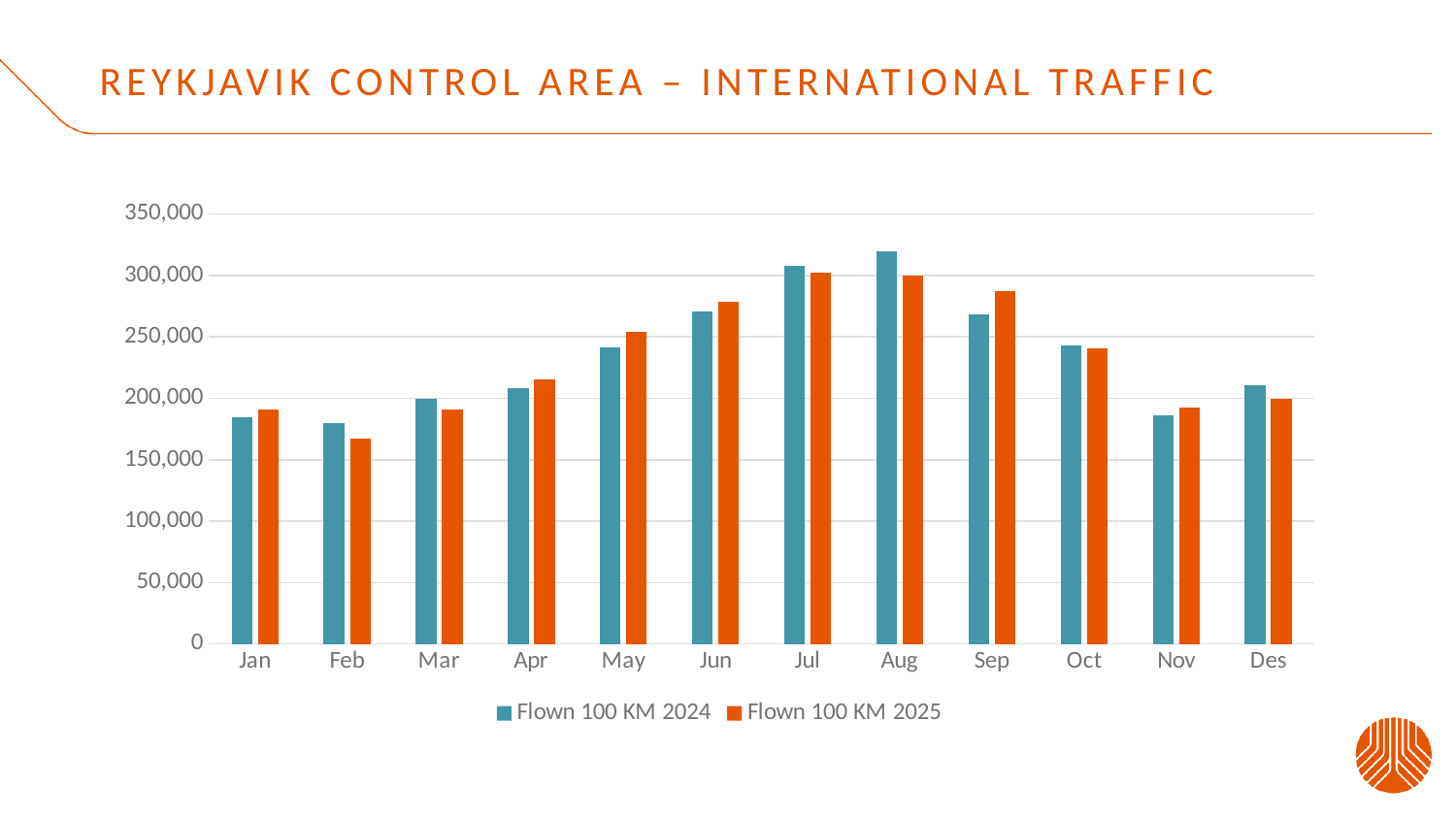
What is the title of the chart on the slide? Reykjavik Control Area – International Traffic How many series does the legend list? 2 In Aug, which series has the larger value, Flown 100 KM 2024 or Flown 100 KM 2025? Flown 100 KM 2024 Which month has the highest value for Flown 100 KM 2024? Aug In Sep, which series has the larger value, Flown 100 KM 2024 or Flown 100 KM 2025? Flown 100 KM 2025 Is the value for Flown 100 KM 2025 in Sep greater or less than 250,000? greater What kind of chart is shown on the slide? bar chart How many months are shown on the x axis? 12 Is the value for Flown 100 KM 2024 in Aug greater or less than 300,000? greater Is the value for Flown 100 KM 2025 in Feb greater or less than 200,000? less Do the Flown 100 KM 2024 values rise or fall from Jan to Aug? rise Which month has the lowest value for Flown 100 KM 2025? Feb